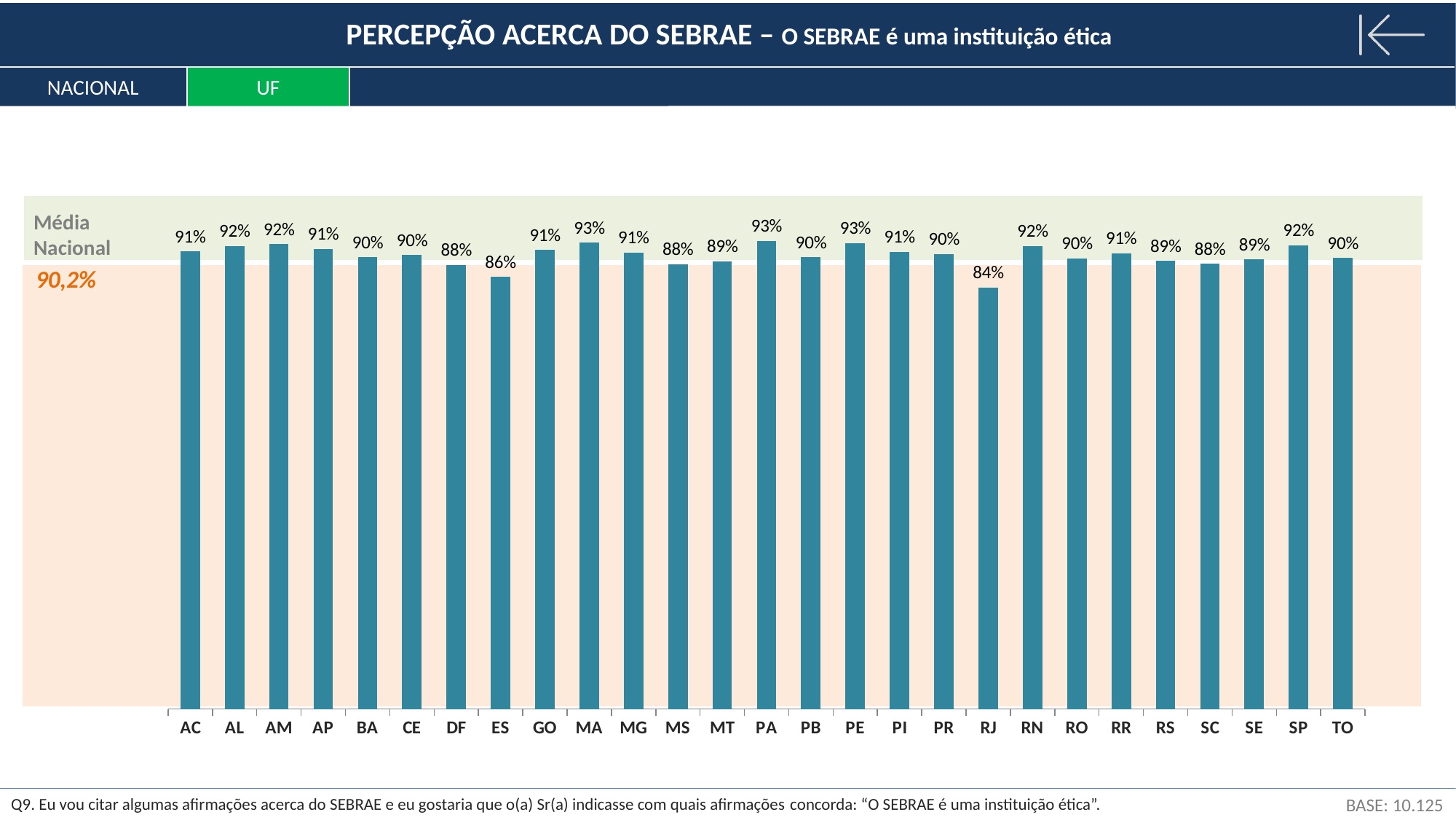
What is the Média Nacional value shown on the chart? 90,2% Which state has the lowest value? RJ What is the value for ES? 86% What is the difference between the values for PA and RJ? 9% Which is larger, the value for RN or the value for SC? RN What is the difference between the values for AM and DF? 4% What is the value for MA? 93% How many states (UFs) are shown on the x axis? 27 What is the value for RJ? 84% Which is larger, the value for ES or the value for PE? PE What is the value for SP? 92% What kind of chart is shown on the slide? Bar chart